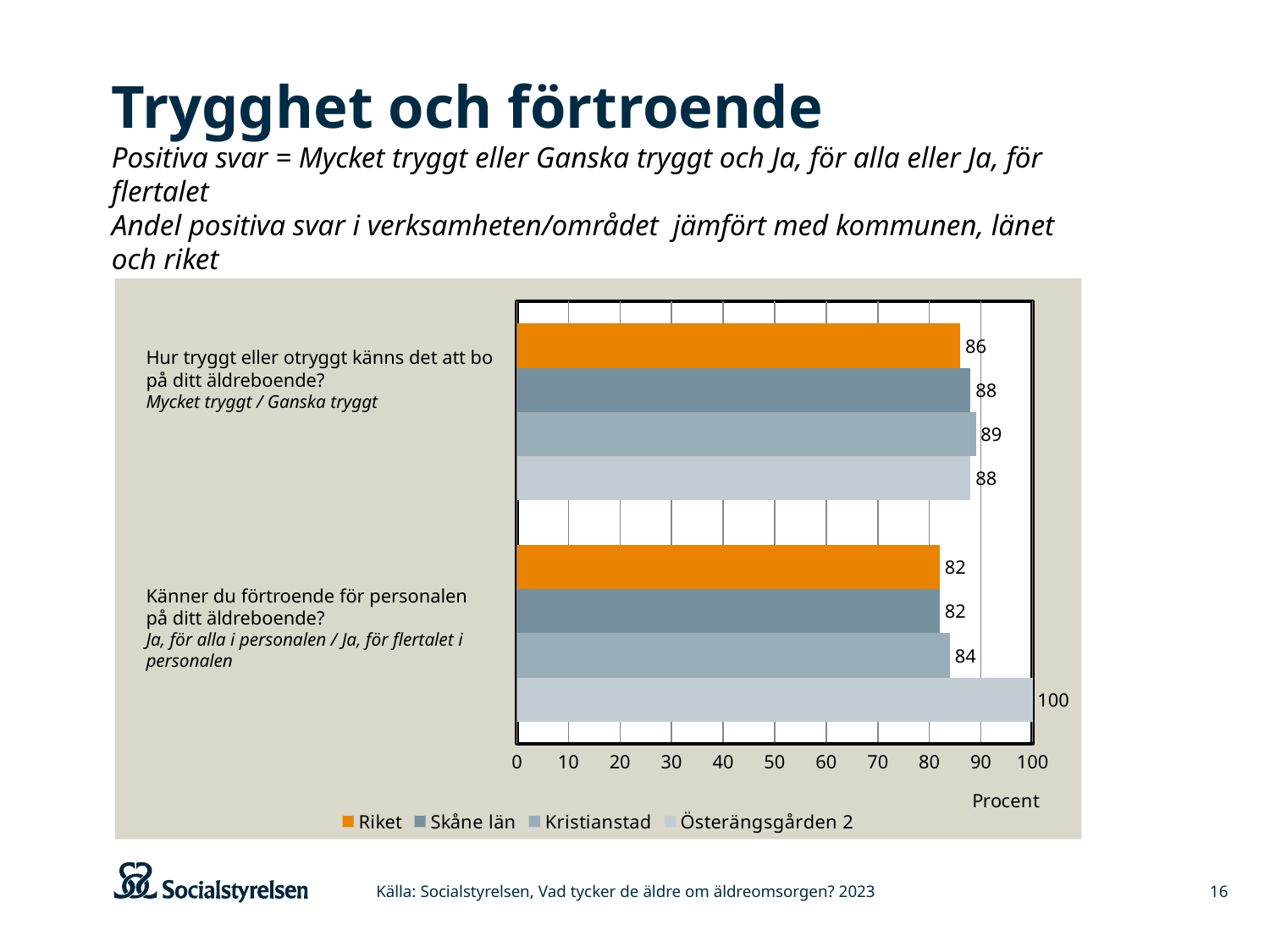
What is the value for Österängsgården 2 on the question "Känner du förtroende för personalen på ditt äldreboende?"? 100 What is the label of the horizontal axis? Procent How many series does the legend list? 4 How many question categories are shown on the chart? 2 What kind of chart is shown on the slide? Bar chart Which series has the lowest value on the question "Hur tryggt eller otryggt känns det att bo på ditt äldreboende?"? Riket Which series has the highest value on the question "Känner du förtroende för personalen på ditt äldreboende?"? Österängsgården 2 What is the difference between Österängsgården 2 and Riket on the question "Känner du förtroende för personalen på ditt äldreboende?"? 18 What is the value for Kristianstad on the question "Hur tryggt eller otryggt känns det att bo på ditt äldreboende?"? 89 Which is larger on the question "Hur tryggt eller otryggt känns det att bo på ditt äldreboende?": Kristianstad or Riket? Kristianstad What is the value for Skåne län on the question "Känner du förtroende för personalen på ditt äldreboende?"? 82 What is the value for Riket on the question "Hur tryggt eller otryggt känns det att bo på ditt äldreboende?"? 86